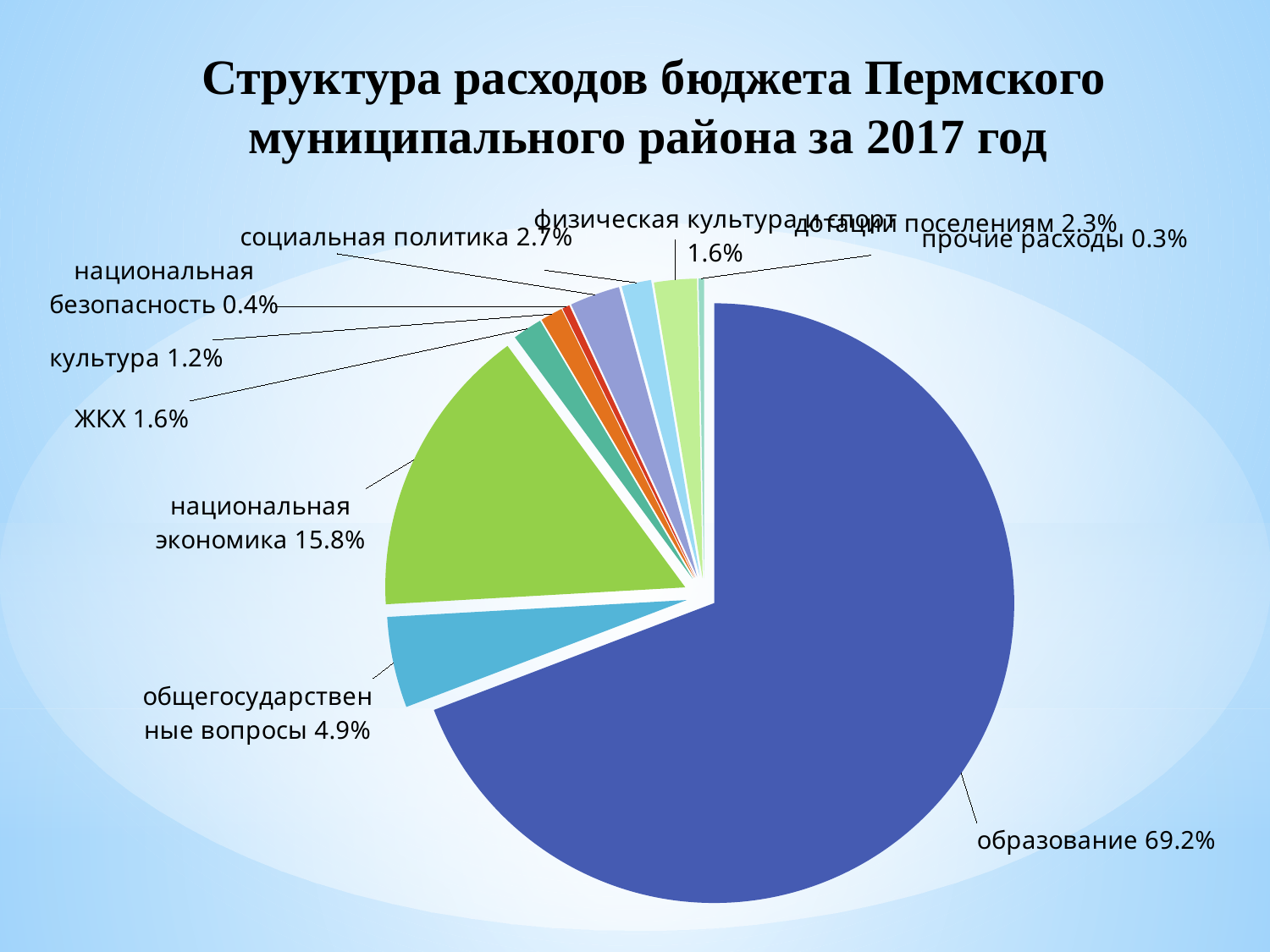
What share of the budget expenditure goes to национальная экономика? 15.8% What share of the budget expenditure goes to общегосударственные вопросы? 4.9% Which category has the smallest share of the budget expenditure? прочие расходы Which has a larger share: культура or ЖКХ? ЖКХ What is the title of the chart on the slide? Структура расходов бюджета Пермского муниципального района за 2017 год What share of the budget expenditure goes to образование? 69.2% What share of the budget expenditure goes to социальная политика? 2.7% What share of the budget expenditure goes to дотации поселениям? 2.3% Which category has the largest share of the budget expenditure? образование What is the difference in percentage points between образование and национальная экономика? 53.4 What kind of chart is shown on the slide? pie chart How many categories are shown in the pie chart? 10